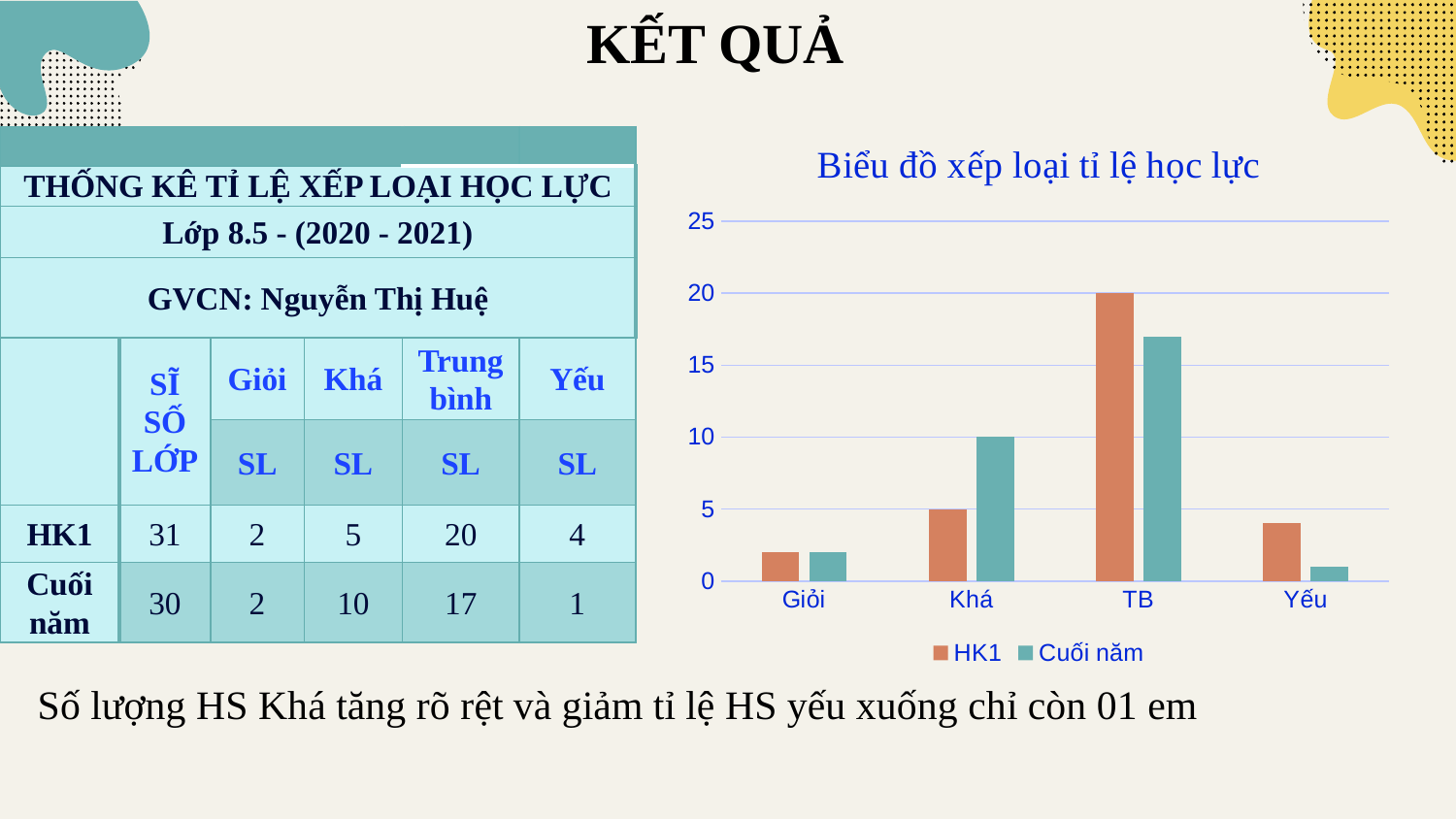
How many categories are shown on the x axis of the chart? 4 Which category has the lowest Cuối năm value in the chart? Yếu What is the Cuối năm value for Khá in the chart? 10 Is the HK1 value for Yếu greater or less than 5? less What is the title of the chart? Biểu đồ xếp loại tỉ lệ học lực What is the HK1 value for TB in the chart? 20 How many series does the chart legend list? 2 Is the Cuối năm value for TB greater or less than 15? greater What is the HK1 value for Khá in the chart? 5 For Khá, which series has the larger value, HK1 or Cuối năm? Cuối năm Which category has the highest HK1 value in the chart? TB What kind of chart is shown on the slide? bar chart